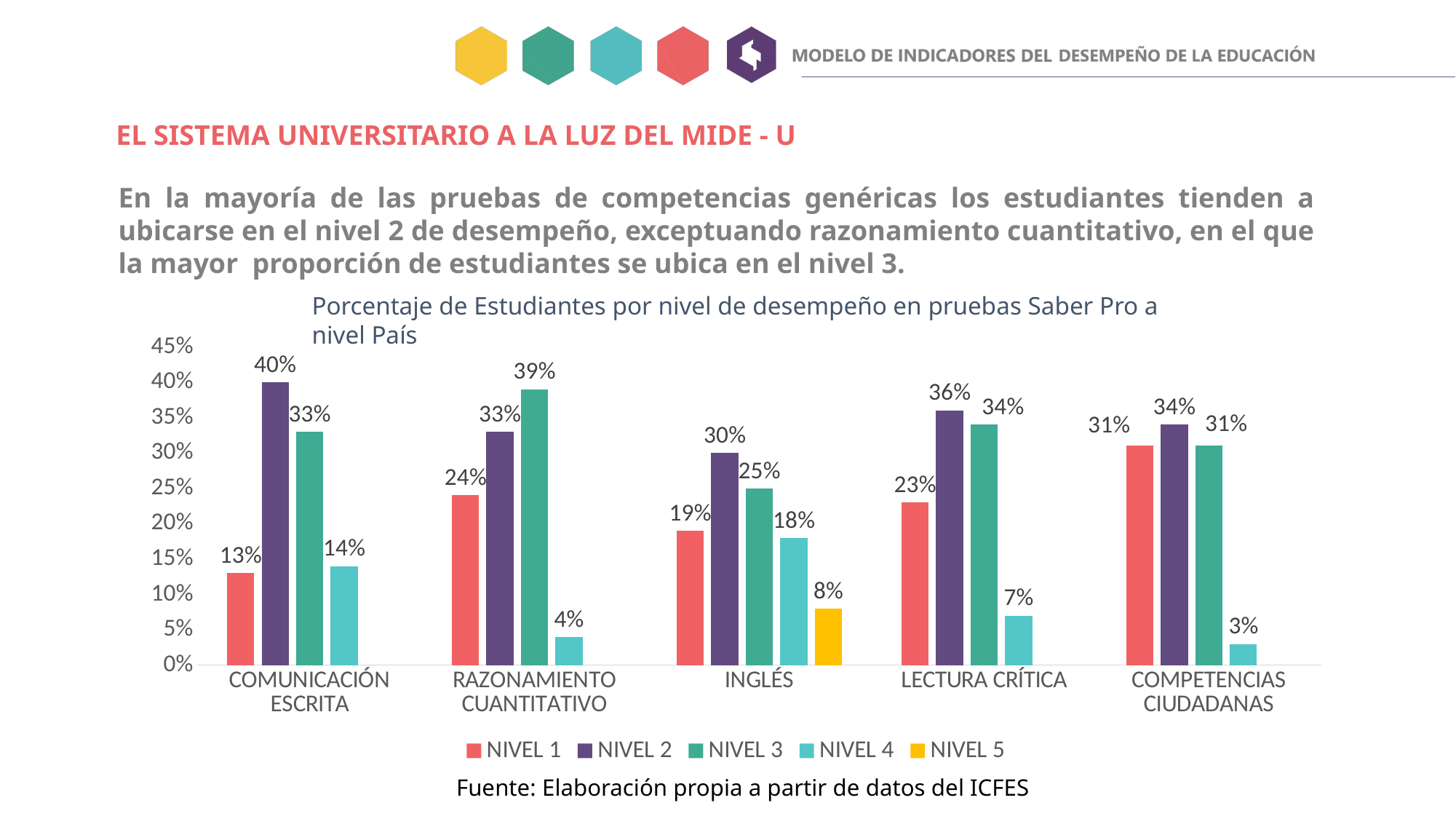
Which is larger in RAZONAMIENTO CUANTITATIVO: NIVEL 2 or NIVEL 3? NIVEL 3 What is the difference between NIVEL 2 and NIVEL 3 in LECTURA CRÍTICA? 2% What is the title of the chart? Porcentaje de Estudiantes por nivel de desempeño en pruebas Saber Pro a nivel País How many series does the legend list? 5 What is the value for NIVEL 3 in RAZONAMIENTO CUANTITATIVO? 39% What kind of chart is shown on the slide? Bar chart Which category has the highest NIVEL 1 value? COMPETENCIAS CIUDADANAS How many categories are shown on the x axis? 5 Which category has the lowest NIVEL 4 value? COMPETENCIAS CIUDADANAS What is the value for NIVEL 5 in INGLÉS? 8% What is the value for NIVEL 4 in COMPETENCIAS CIUDADANAS? 3% What is the value for NIVEL 2 in COMUNICACIÓN ESCRITA? 40%